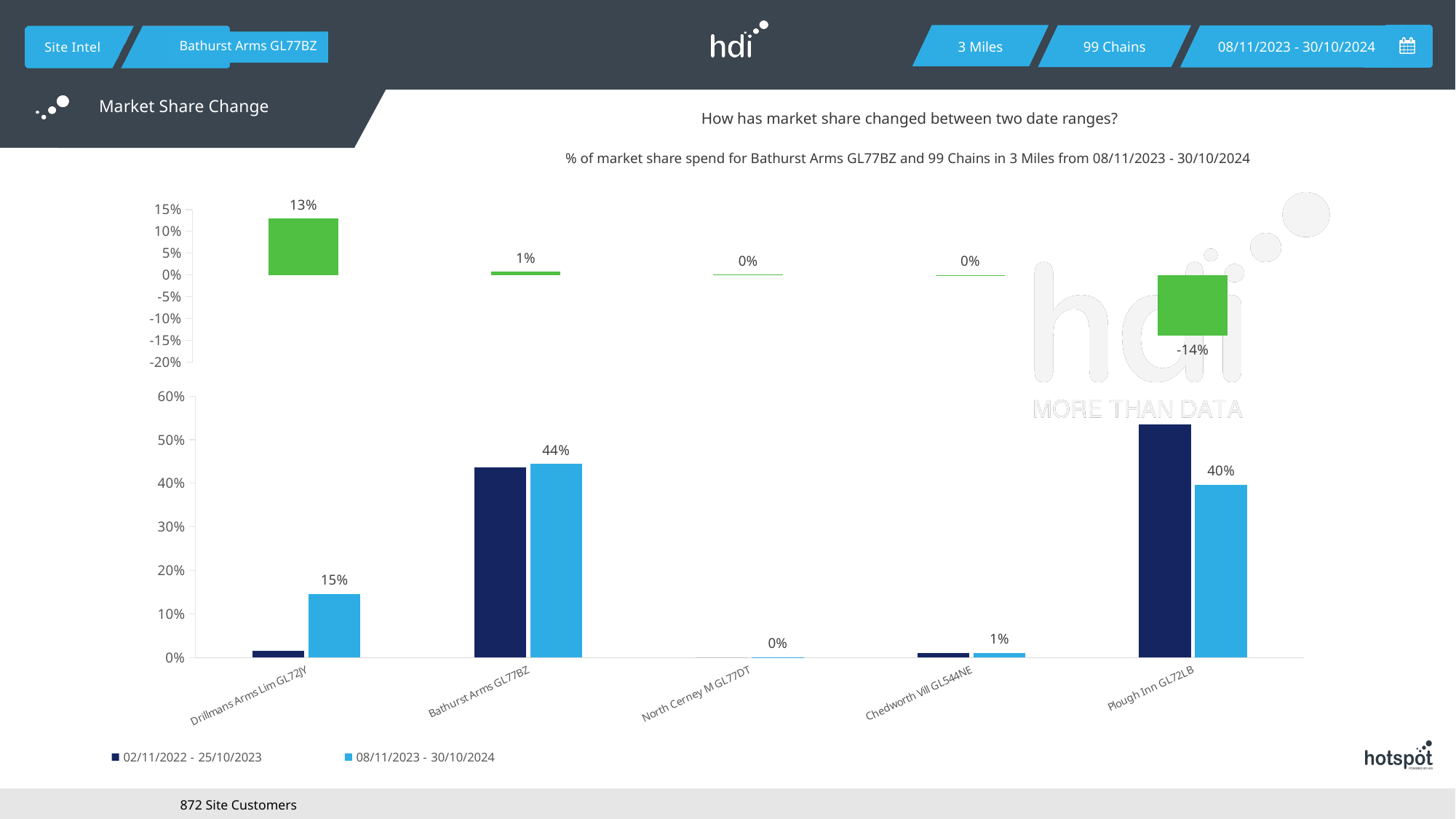
In the top chart, which site has the lowest market share change? Plough Inn GL72LB How many series does the legend of the bottom chart list? 2 What type of chart is the bottom chart? Bar chart In the bottom chart, is the value for Plough Inn GL72LB in the 02/11/2022 - 25/10/2023 series greater or less than 50%? greater In the top chart, what is the market share change for Plough Inn GL72LB? -14% How many sites are shown on the x axis of the bottom chart? 5 In the top chart, what is the market share change for Drillmans Arms Lim GL72JY? 13% In the top chart, what is the difference between the market share change for Drillmans Arms Lim GL72JY and Bathurst Arms GL77BZ? 12% In the bottom chart, what is the value for Bathurst Arms GL77BZ in the 08/11/2023 - 30/10/2024 series? 44% In the bottom chart, which is larger for Drillmans Arms Lim GL72JY: the 02/11/2022 - 25/10/2023 value or the 08/11/2023 - 30/10/2024 value? 08/11/2023 - 30/10/2024 In the top chart, which site has the highest market share change? Drillmans Arms Lim GL72JY In the bottom chart, what is the value for Plough Inn GL72LB in the 08/11/2023 - 30/10/2024 series? 40%